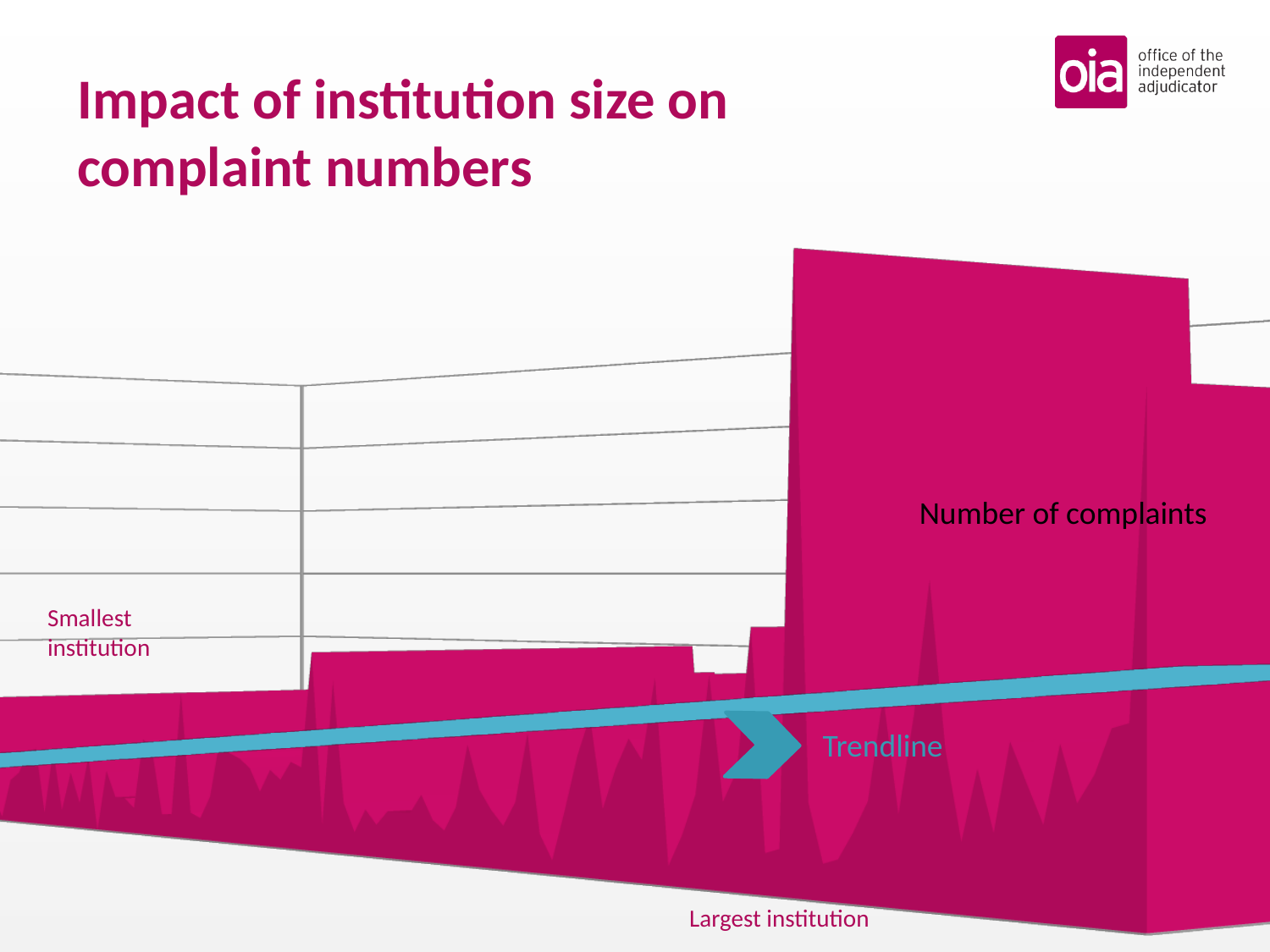
What does the blue line on the chart represent? Trendline What kind of chart is shown on the slide? area chart What is the title of the chart on this slide? Impact of institution size on complaint numbers What quantity is plotted in the pink area of the chart? Number of complaints Which end of the x axis is labelled 'Largest institution', the left or the right? right Is the number of complaints generally higher for the smallest institutions or the largest institutions? largest institutions Does the trendline rise or fall as institutions go from smallest to largest? rise